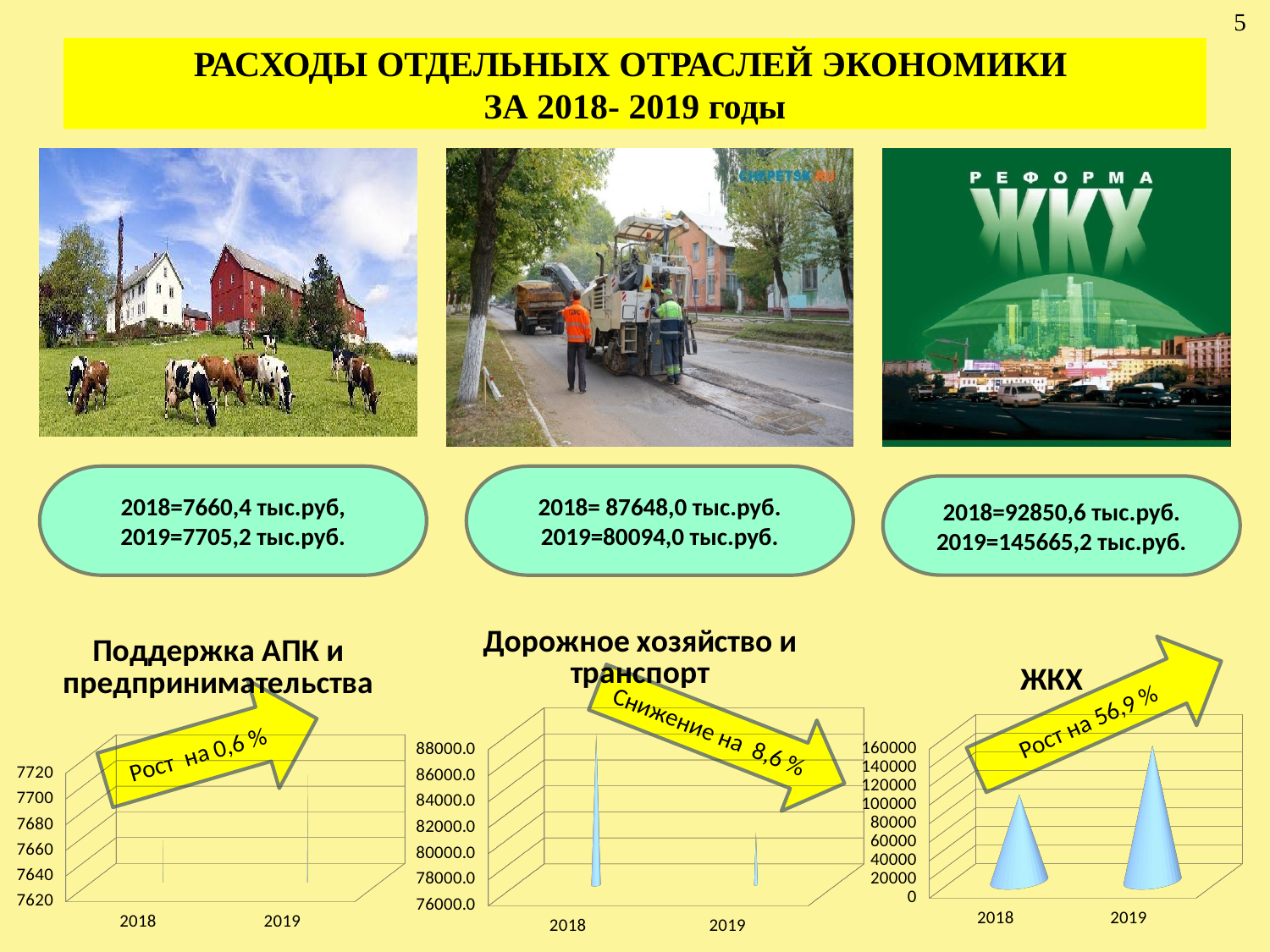
In the "Дорожное хозяйство и транспорт" chart, do the values rise or fall from 2018 to 2019? fall In the "Поддержка АПК и предпринимательства" chart, do the values rise or fall from 2018 to 2019? rise What percentage change is written on the arrow over the "ЖКХ" chart? Рост на 56,9 % In the "ЖКХ" chart, is the value for 2018 greater or less than 100000? less In the "Дорожное хозяйство и транспорт" chart, is the value for 2019 greater or less than 82000? less How many categories are shown on the x axis of the "ЖКХ" chart? 2 What kind of chart is the "Поддержка АПК и предпринимательства" chart? bar chart In the "Дорожное хозяйство и транспорт" chart, which year has the larger value, 2018 or 2019? 2018 In the "ЖКХ" chart, do the values rise or fall from 2018 to 2019? rise In the "ЖКХ" chart, is the value for 2019 greater or less than 120000? greater In the "ЖКХ" chart, which year has the larger value, 2018 or 2019? 2019